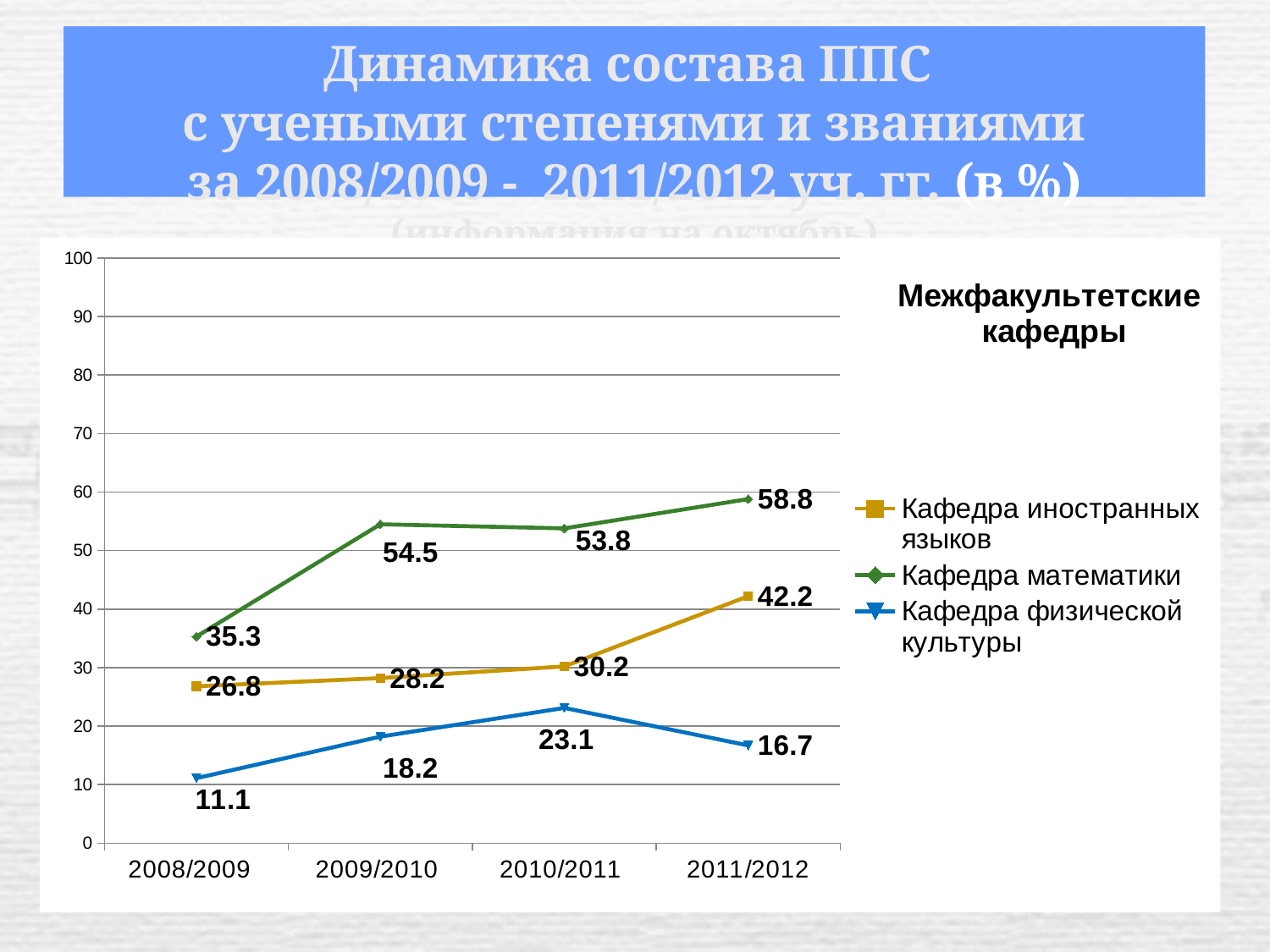
What is the value for Кафедра физической культуры in 2008/2009? 11.1 Which series has the larger value in 2010/2011: Кафедра иностранных языков or Кафедра физической культуры? Кафедра иностранных языков How many series does the legend list? 3 Does the value for Кафедра иностранных языков rise or fall from 2008/2009 to 2011/2012? rise What is the difference between Кафедра математики and Кафедра иностранных языков in 2011/2012? 16.6 In which year does Кафедра математики have its lowest value? 2008/2009 In which year does Кафедра физической культуры reach its highest value? 2010/2011 How many academic years are shown on the x axis? 4 What type of chart is shown on the slide? line chart What is the value for Кафедра иностранных языков in 2011/2012? 42.2 What is the title of the chart? Межфакультетские кафедры What is the value for Кафедра математики in 2009/2010? 54.5